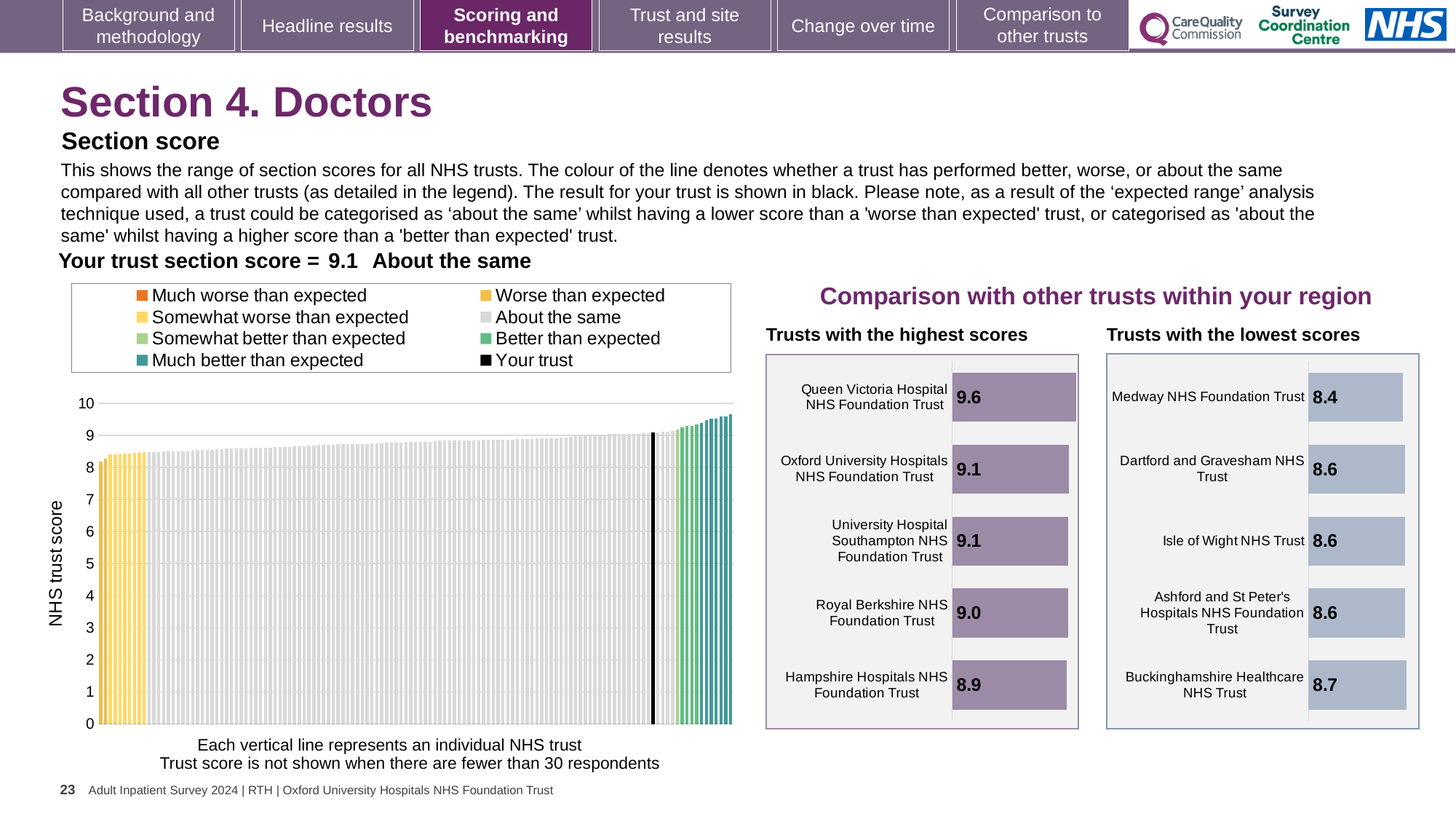
In the 'Trusts with the lowest scores' chart, which has the larger score: Medway NHS Foundation Trust or Buckinghamshire Healthcare NHS Trust? Buckinghamshire Healthcare NHS Trust What kind of chart is the NHS trust score chart on the left of the slide? Bar chart How many trusts are shown in the 'Trusts with the highest scores' chart? 5 In the 'Trusts with the highest scores' chart, what is the score for Hampshire Hospitals NHS Foundation Trust? 8.9 In the 'Trusts with the lowest scores' chart, what is the score for Buckinghamshire Healthcare NHS Trust? 8.7 In the NHS trust score chart on the left, what colour represents 'Your trust'? Black In the 'Trusts with the highest scores' chart, what is the score for Queen Victoria Hospital NHS Foundation Trust? 9.6 In the 'Trusts with the highest scores' chart, what is the difference between the scores of Queen Victoria Hospital NHS Foundation Trust and Hampshire Hospitals NHS Foundation Trust? 0.7 In the 'Trusts with the lowest scores' chart, what is the score for Medway NHS Foundation Trust? 8.4 How many entries does the legend of the NHS trust score chart on the left list? 8 In the 'Trusts with the lowest scores' chart, which trust has the lowest score? Medway NHS Foundation Trust In the 'Trusts with the highest scores' chart, which trust has the highest score? Queen Victoria Hospital NHS Foundation Trust